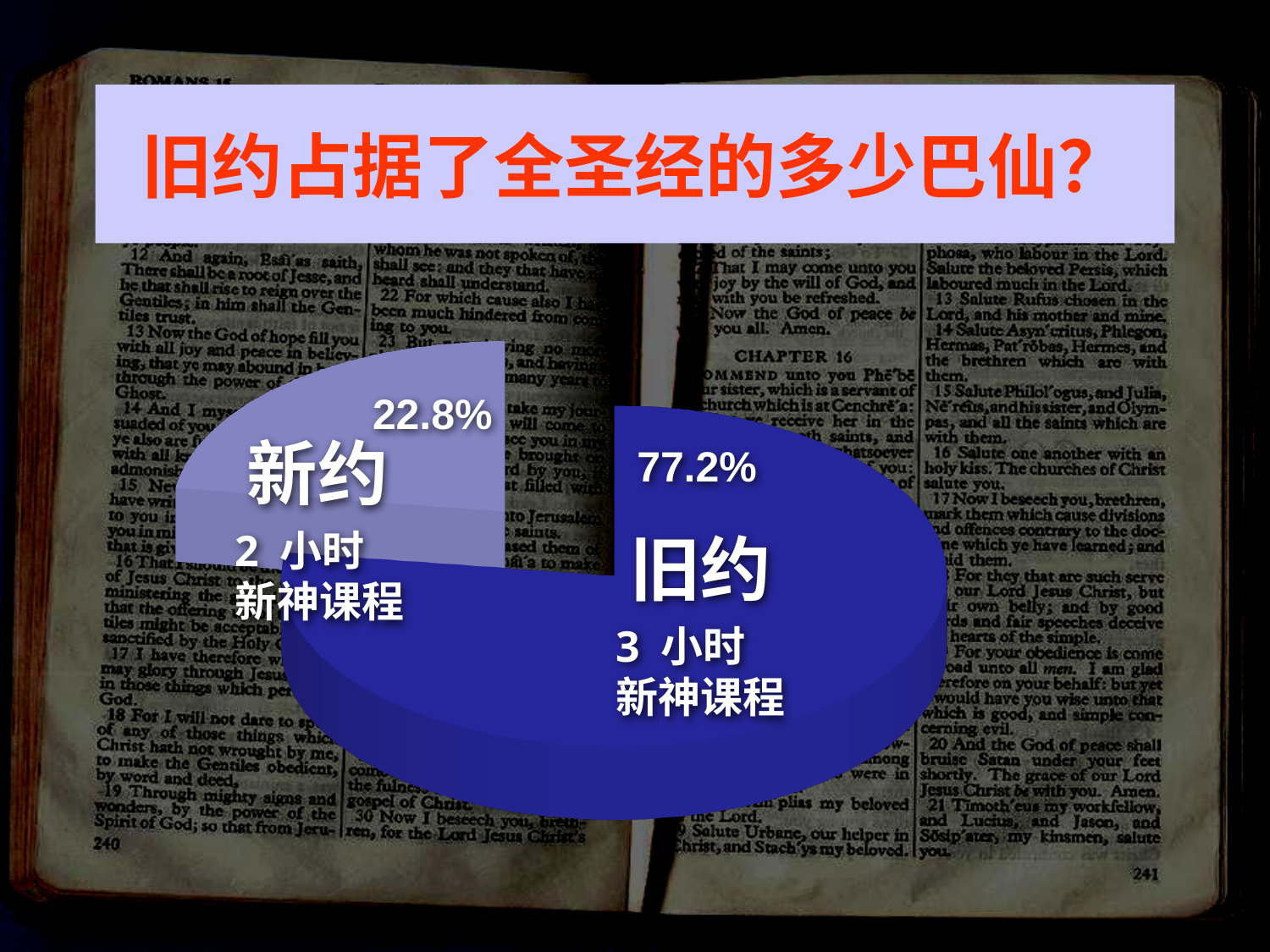
Which slice of the pie is the largest? 旧约 What is the difference in percentage points between the 旧约 slice and the 新约 slice? 54.4 Which is larger, the 旧约 slice or the 新约 slice? 旧约 Which slice of the pie is the smallest? 新约 What percentage of the pie does 旧约 occupy? 77.2% How many hours of 新神课程 are labelled for the 新约 slice? 2 小时 What percentage of the pie does 新约 occupy? 22.8% What is the title of the slide above the pie chart? 旧约占据了全圣经的多少巴仙? How many slices does the pie chart have? 2 What kind of chart is shown on the slide? pie chart What is the combined percentage of the two slices in the pie chart? 100% How many hours of 新神课程 are labelled for the 旧约 slice? 3 小时